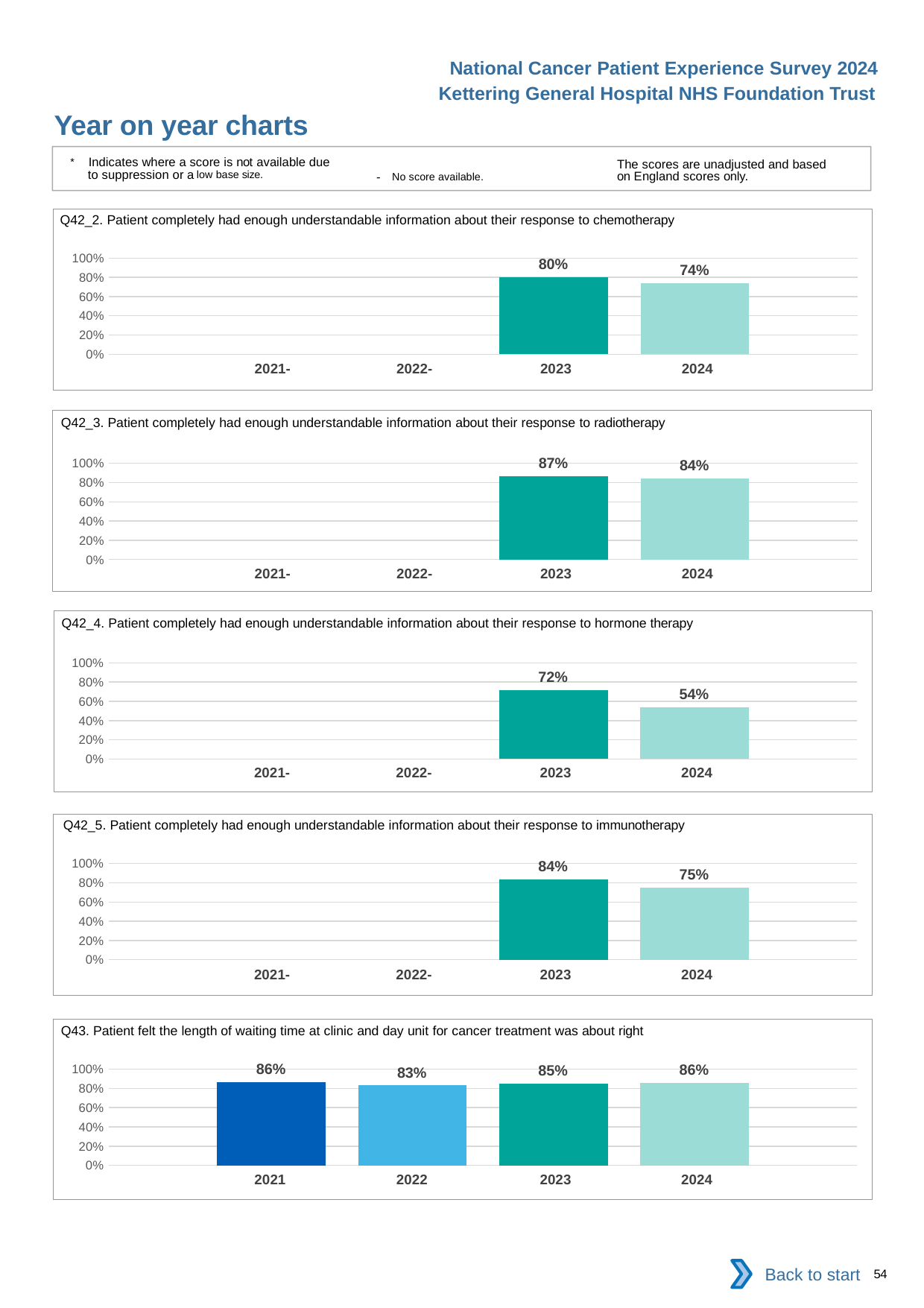
In the Q42_3 chart (radiotherapy), does the value rise or fall from 2023 to 2024? Fall In the Q42_2 chart (chemotherapy), how many years have a bar plotted? 2 In the Q43 chart (waiting time at clinic and day unit), what is the value for 2021? 86% What kind of chart is used for Q42_2 (chemotherapy)? Bar chart How many charts are shown on the slide? 5 In the Q43 chart (waiting time at clinic and day unit), how many years have a bar plotted? 4 In the Q42_4 chart (hormone therapy), what is the difference between the 2023 and 2024 values? 18% In the Q42_4 chart (hormone therapy), is the value for 2024 greater or less than 60%? less In the Q43 chart (waiting time at clinic and day unit), which year has the lowest value? 2022 In the Q42_3 chart (radiotherapy), what is the value for 2024? 84% In the Q42_5 chart (immunotherapy), which year has the higher value, 2023 or 2024? 2023 In the Q42_2 chart (chemotherapy), what is the value for 2023? 80%